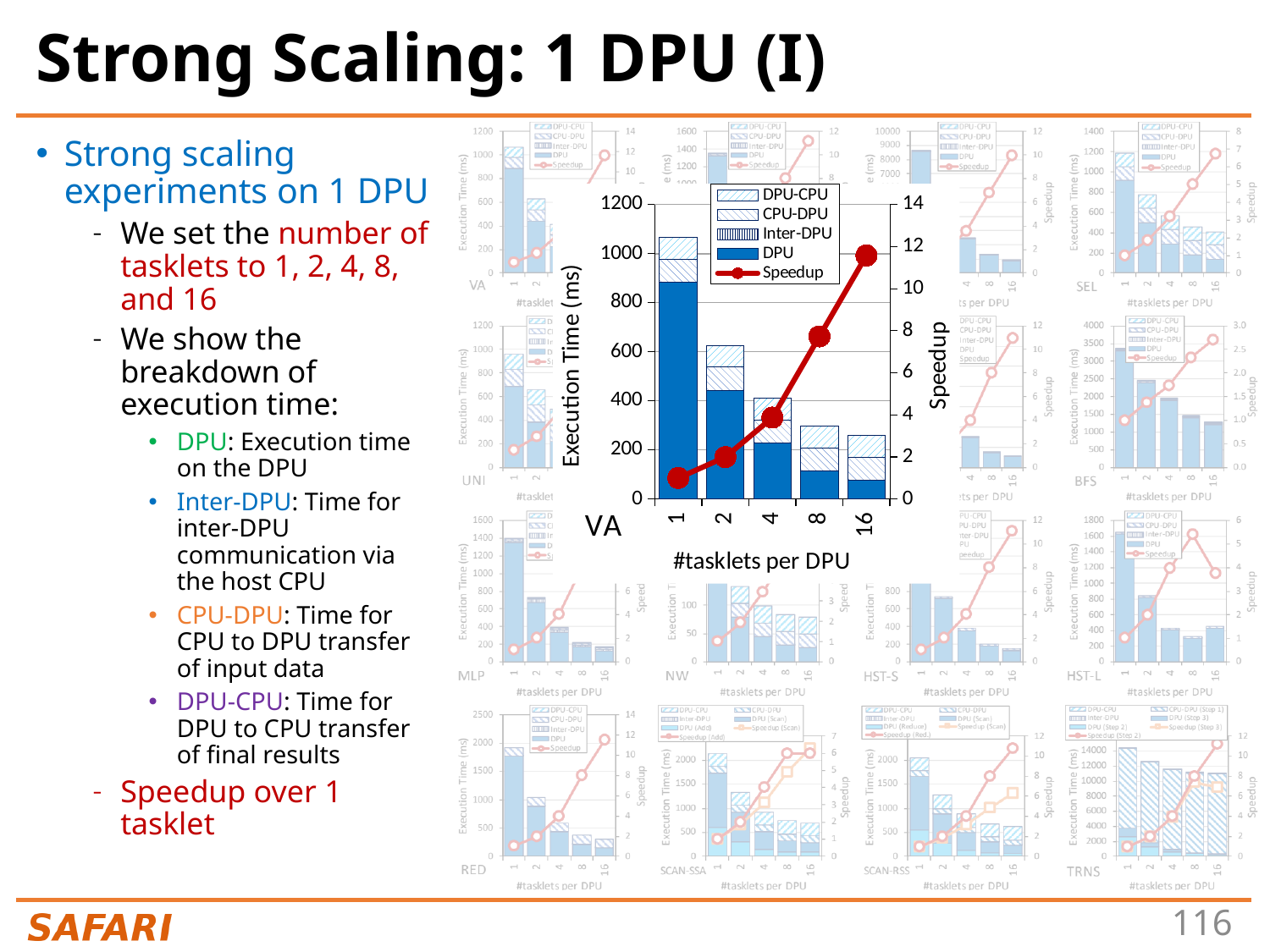
On the large central chart labeled VA, how does the total execution time change as the number of tasklets per DPU increases from 1 to 16? It falls On the large central chart labeled VA, is the speedup for 16 tasklets greater or less than 10? greater On the large central chart labeled VA, what is the label of the x axis? #tasklets per DPU On the large central chart labeled VA, what kind of chart is used for the execution time breakdown? Stacked bar chart On the large central chart labeled VA, is the speedup for 8 tasklets greater or less than 6? greater On the large central chart labeled VA, is the total execution time for 1 tasklet greater or less than 1000 ms? greater On the large central chart labeled VA, which number of tasklets has the highest total execution time? 1 On the large central chart labeled VA, how many entries does the legend list? 5 On the large central chart labeled VA, which number of tasklets has the highest speedup? 16 On the large central chart labeled VA, how many tasklet counts are shown on the x axis? 5